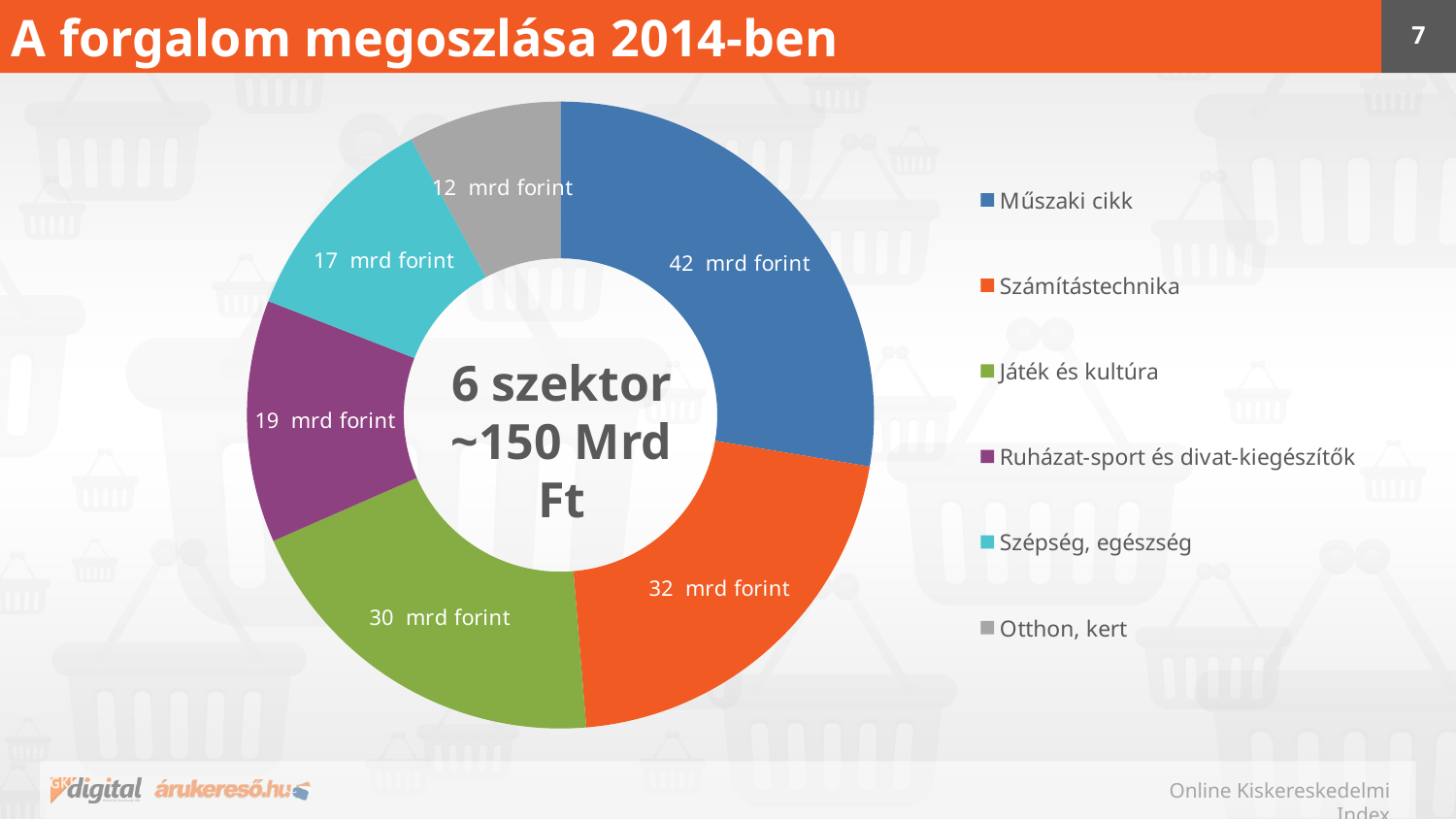
What is the value for Ruházat-sport és divat-kiegészítők? 19 mrd forint What is the value for Játék és kultúra? 30 mrd forint How many categories does the chart show? 6 Which category has the largest share of the chart? Műszaki cikk What kind of chart is shown on the slide? doughnut chart Which category has the smallest share of the chart? Otthon, kert Which is larger, the value for Szépség, egészség or the value for Ruházat-sport és divat-kiegészítők? Ruházat-sport és divat-kiegészítők What is the value for Műszaki cikk? 42 mrd forint What is the value for Számítástechnika? 32 mrd forint What is the title of the slide? A forgalom megoszlása 2014-ben What is the value for Otthon, kert? 12 mrd forint What is the difference between the values for Műszaki cikk and Számítástechnika? 10 mrd forint